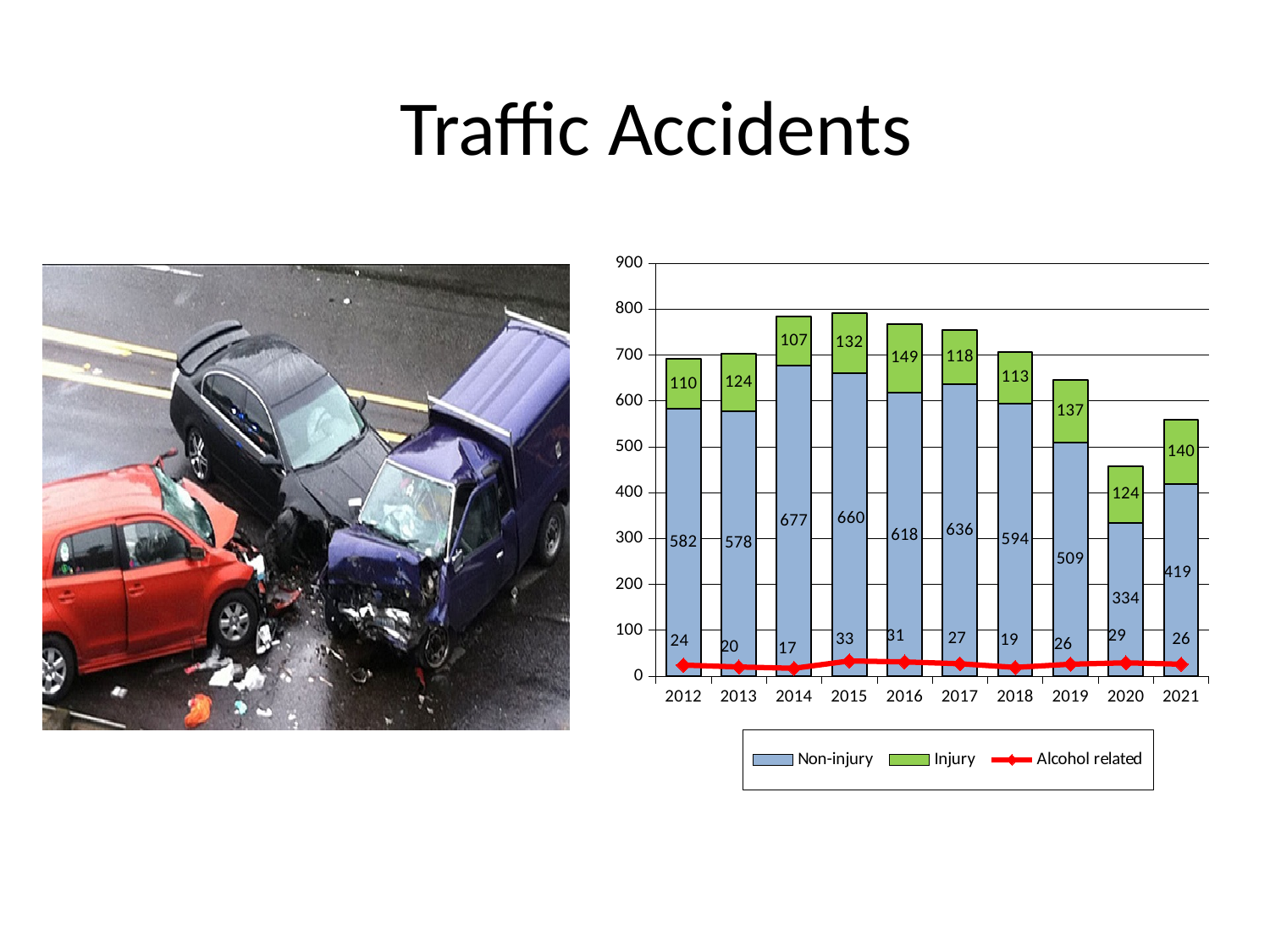
What is the total of the stacked bar (Non-injury plus Injury) for 2020? 458 What is the Injury value for 2016? 149 What is the Alcohol related value for 2015? 33 What kind of chart is shown on the slide? Stacked bar chart with a line What is the Non-injury value for 2014? 677 What is the difference between the Non-injury values for 2014 and 2020? 343 How many years are shown on the x axis? 10 Which year has the lowest Alcohol related value? 2014 Which is larger, the Injury value for 2015 or for 2018? 2015 Which year has the lowest Non-injury value? 2020 Which year has the highest Injury value? 2016 How many series does the legend list? 3